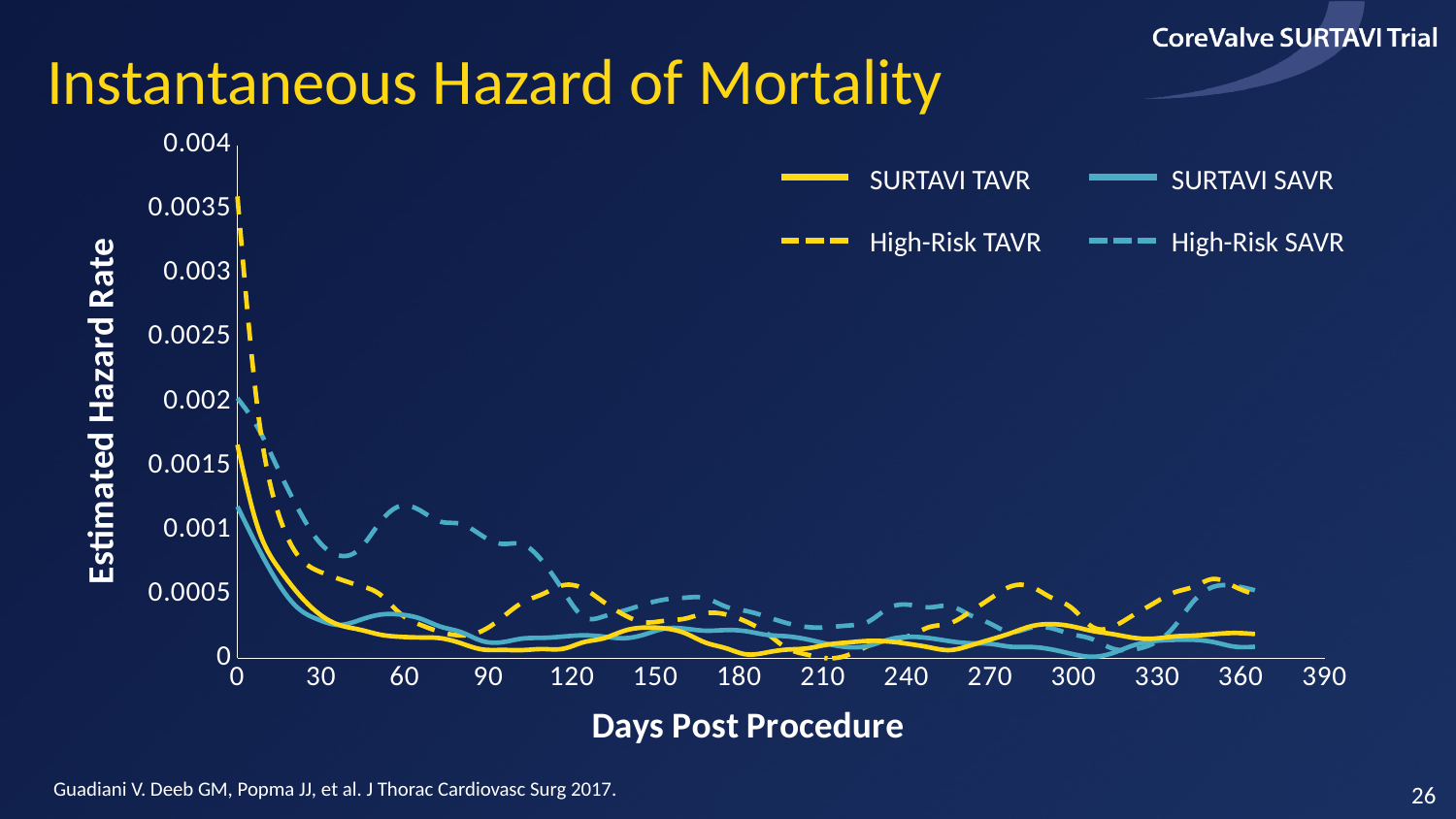
Is the value for High-Risk TAVR at day 0 greater or less than 0.003? greater What kind of chart is shown on the slide? line chart Is the value for High-Risk SAVR at day 60 greater or less than 0.001? greater Is the value for SURTAVI TAVR at day 0 greater or less than 0.001? greater Which series has the highest estimated hazard rate at day 0? High-Risk TAVR How many series does the legend list? 4 What is the title of the chart? Instantaneous Hazard of Mortality What is the label of the x axis? Days Post Procedure What is the highest value shown on the y axis? 0.004 At day 60, which is higher: High-Risk SAVR or SURTAVI SAVR? High-Risk SAVR Does the SURTAVI TAVR hazard rate rise or fall between day 0 and day 30? fall